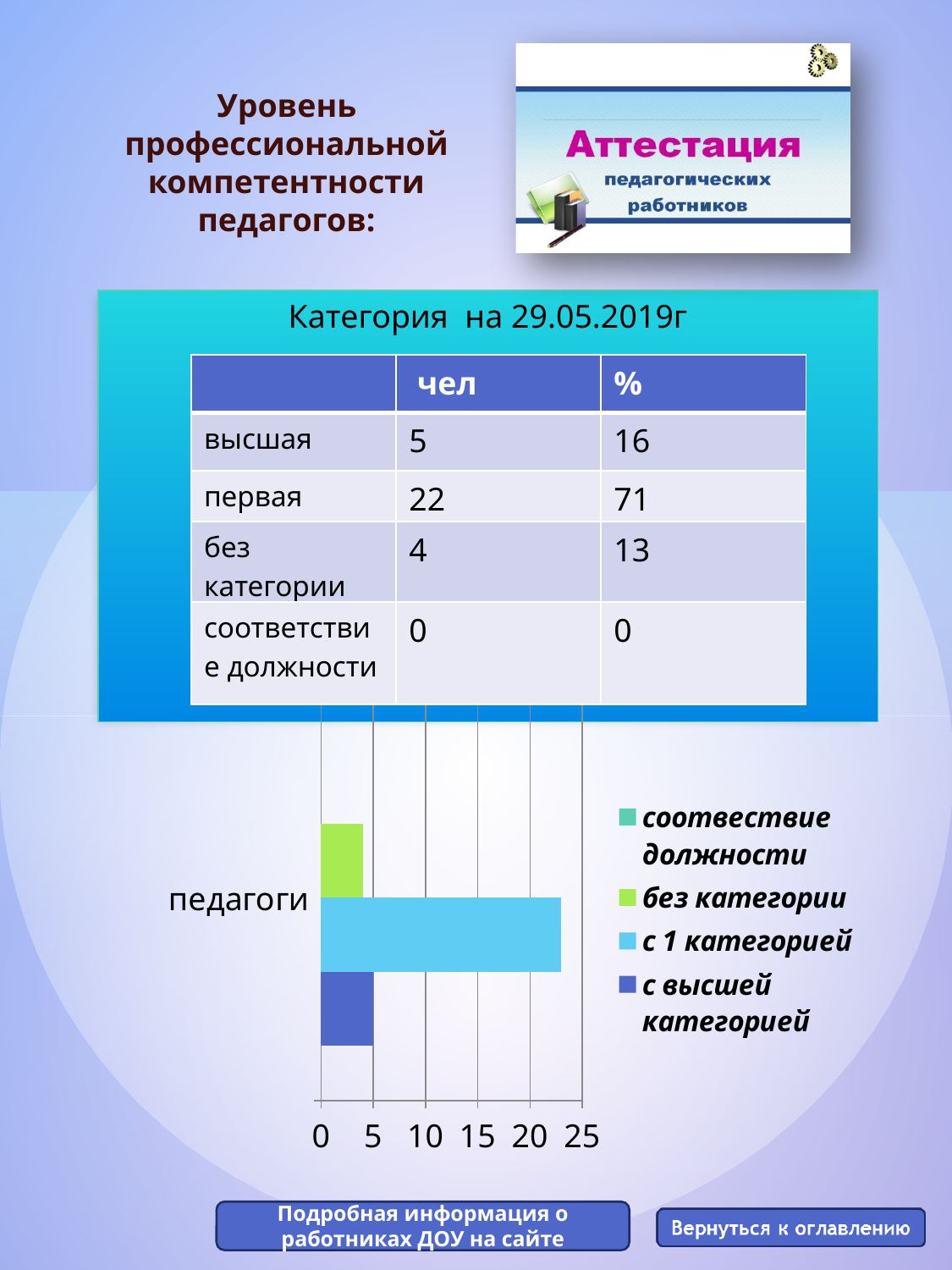
Which bar is longer: 'с 1 категорией' or 'без категории'? с 1 категорией How many series does the chart legend list? 4 What kind of chart is shown on the slide? bar chart Is the value for 'с 1 категорией' greater or less than 25? less What is the category label on the chart's vertical axis? педагоги Which series has the longest bar in the chart? с 1 категорией Which bar is longer: 'с 1 категорией' or 'с высшей категорией'? с 1 категорией Is the value for 'с 1 категорией' greater or less than 20? greater Is the value for 'без категории' greater or less than 10? less How many categories are shown on the chart's vertical axis? 1 What is the highest value shown on the chart's horizontal axis? 25 What value does the bar for 'с высшей категорией' reach on the horizontal axis? 5